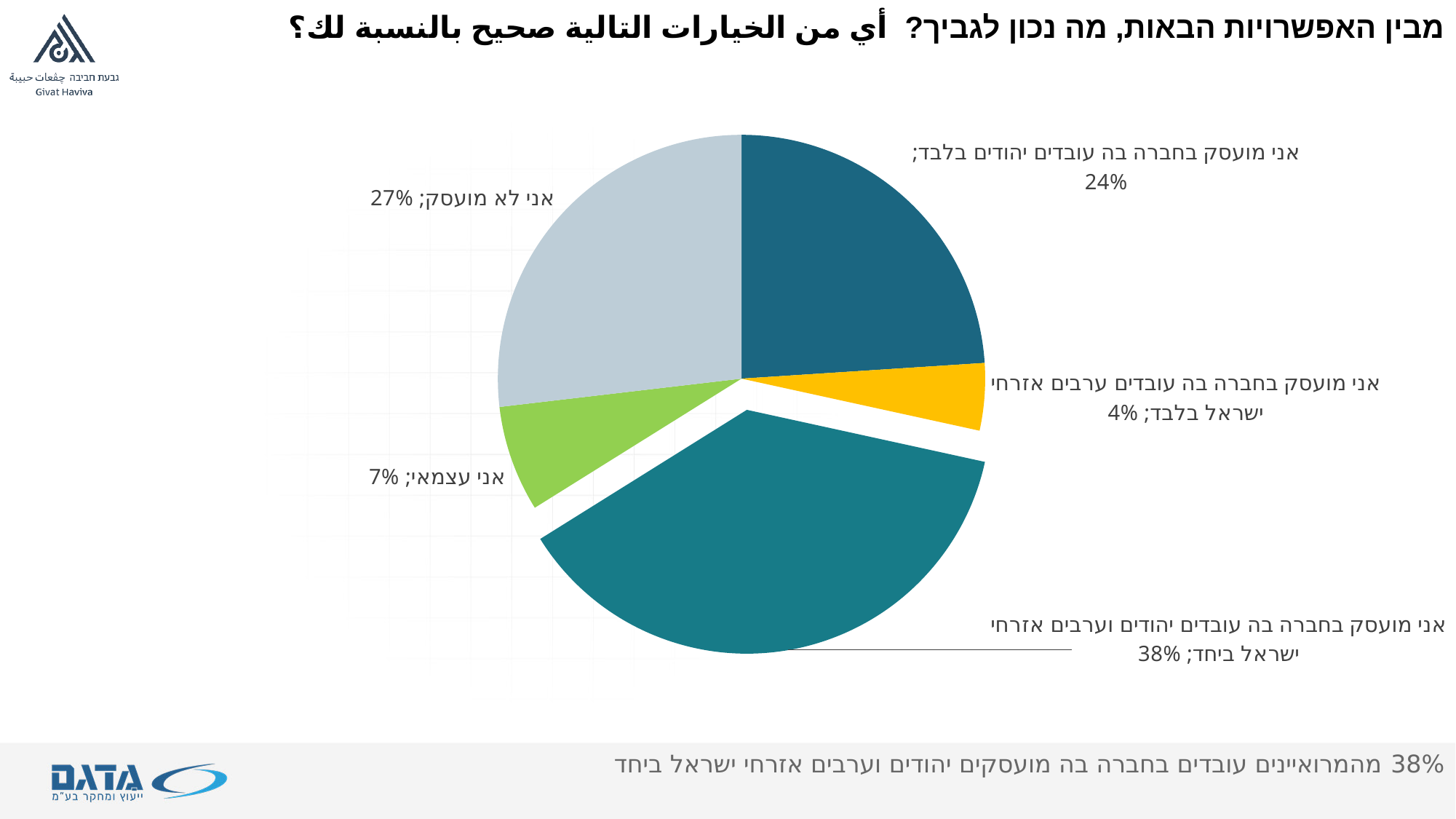
What percentage is shown for "אני עצמאי"? 7% What is the difference in percentage points between "אני לא מועסק" and "אני מועסק בחברה בה עובדים יהודים בלבד"? 3 How many slices does the pie chart have? 5 What percentage is shown for "אני מועסק בחברה בה עובדים יהודים וערבים אזרחי ישראל ביחד"? 38% What percentage is shown for "אני מועסק בחברה בה עובדים ערבים אזרחי ישראל בלבד"? 4% What percentage is shown for "אני מועסק בחברה בה עובדים יהודים בלבד"? 24% Which category has the largest share of the pie? אני מועסק בחברה בה עובדים יהודים וערבים אזרחי ישראל ביחד Which is larger: the share for "אני לא מועסק" or the share for "אני עצמאי"? אני לא מועסק Which category has the smallest share of the pie? אני מועסק בחברה בה עובדים ערבים אזרחי ישראל בלבד What percentage is shown for "אני לא מועסק"? 27% Which slice of the pie is pulled out (exploded) from the rest? אני מועסק בחברה בה עובדים יהודים וערבים אזרחי ישראל ביחד What kind of chart is shown on the slide? pie chart